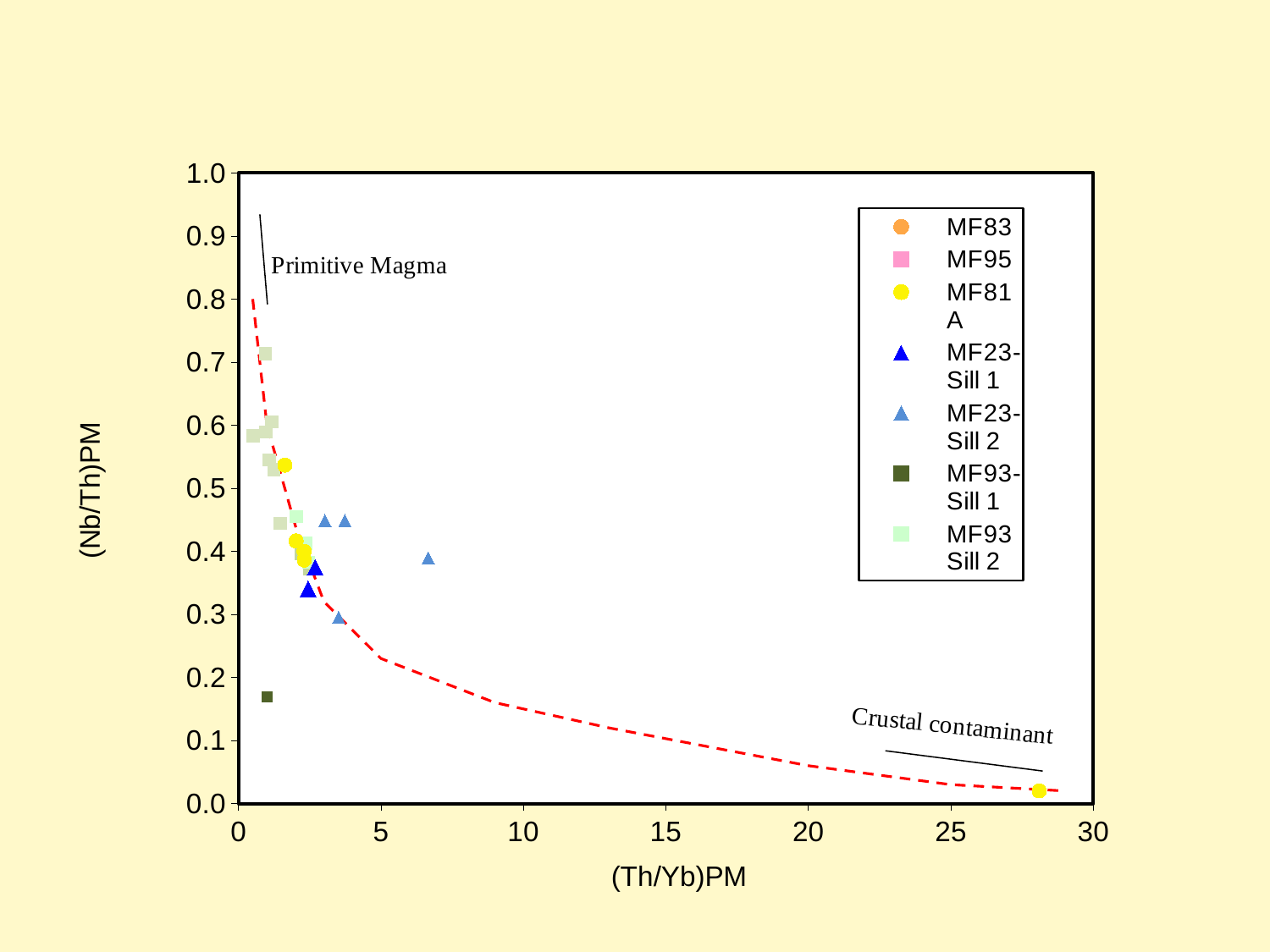
Does the dashed red curve rise or fall as (Th/Yb)PM increases? fall What is the label on the x axis? (Th/Yb)PM Is the (Nb/Th)PM value for the MF93-Sill 1 point greater or less than 0.2? less What kind of chart is shown on the slide? scatter chart Which has a higher (Nb/Th)PM value: the MF93-Sill 1 point or the MF23-Sill 1 points? MF23-Sill 1 Is the (Th/Yb)PM value of the MF81A point nearest the 'Crustal contaminant' label greater or less than 25? greater Which series has the point with the highest (Nb/Th)PM value on the chart? MF93 Sill 2 Is the (Nb/Th)PM value of the highest MF93 Sill 2 point greater or less than 0.6? greater Which series has the point with the lowest (Nb/Th)PM value on the chart? MF81A How many series does the legend list? 7 What is the label on the y axis? (Nb/Th)PM